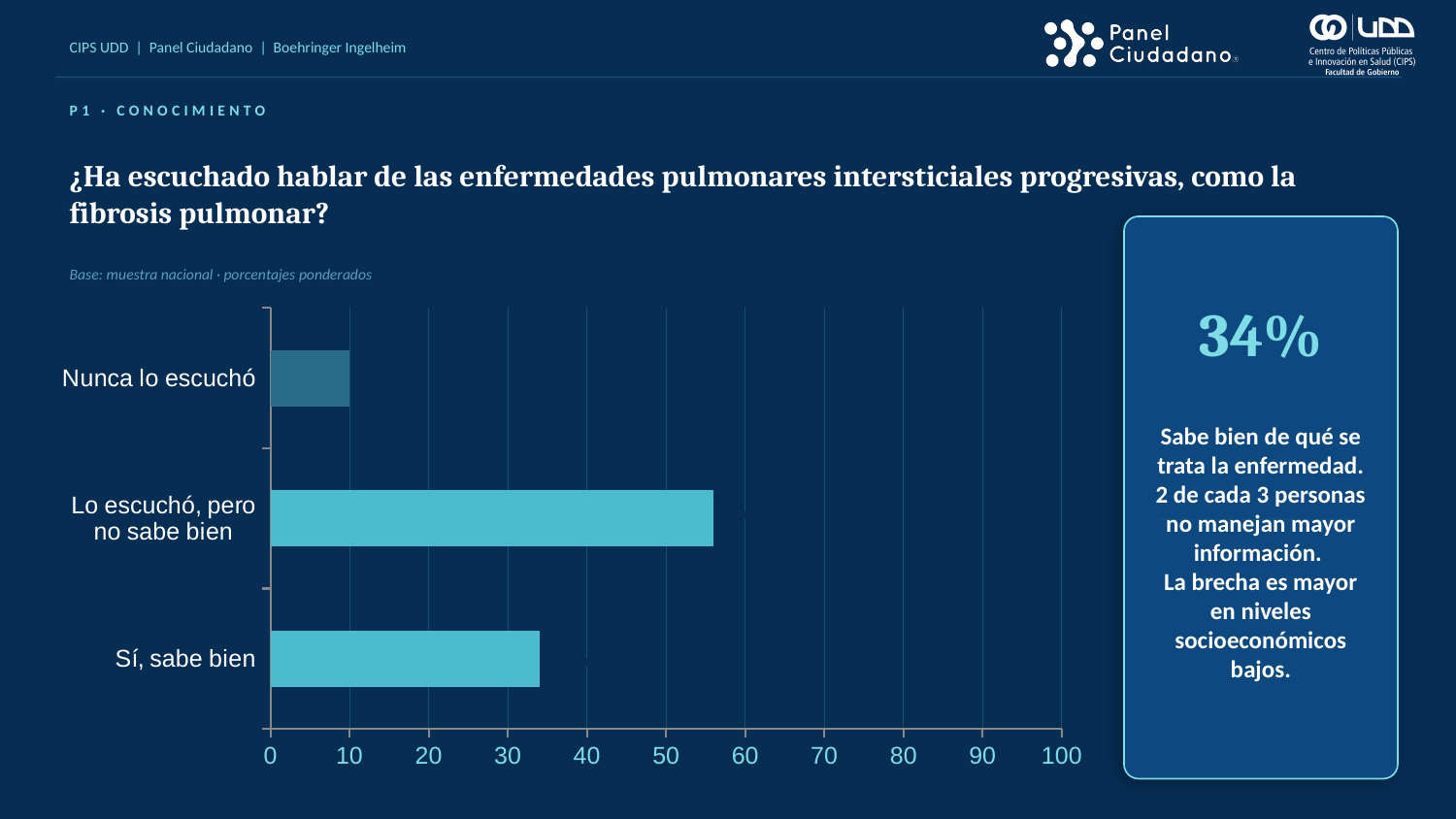
Is the value for "Sí, sabe bien" greater or less than 30? greater Which category has the highest value? Lo escuchó, pero no sabe bien What kind of chart is shown on the slide? bar chart What is the highest value shown on the horizontal axis of the chart? 100 Is the value for "Sí, sabe bien" greater or less than 40? less How many categories are plotted in the chart? 3 What base note is printed above the chart? Base: muestra nacional · porcentajes ponderados Is the value for "Lo escuchó, pero no sabe bien" greater or less than 50? greater What is the value for "Nunca lo escuchó"? 10 Which is larger, the value for "Sí, sabe bien" or the value for "Nunca lo escuchó"? Sí, sabe bien Which category has the lowest value? Nunca lo escuchó